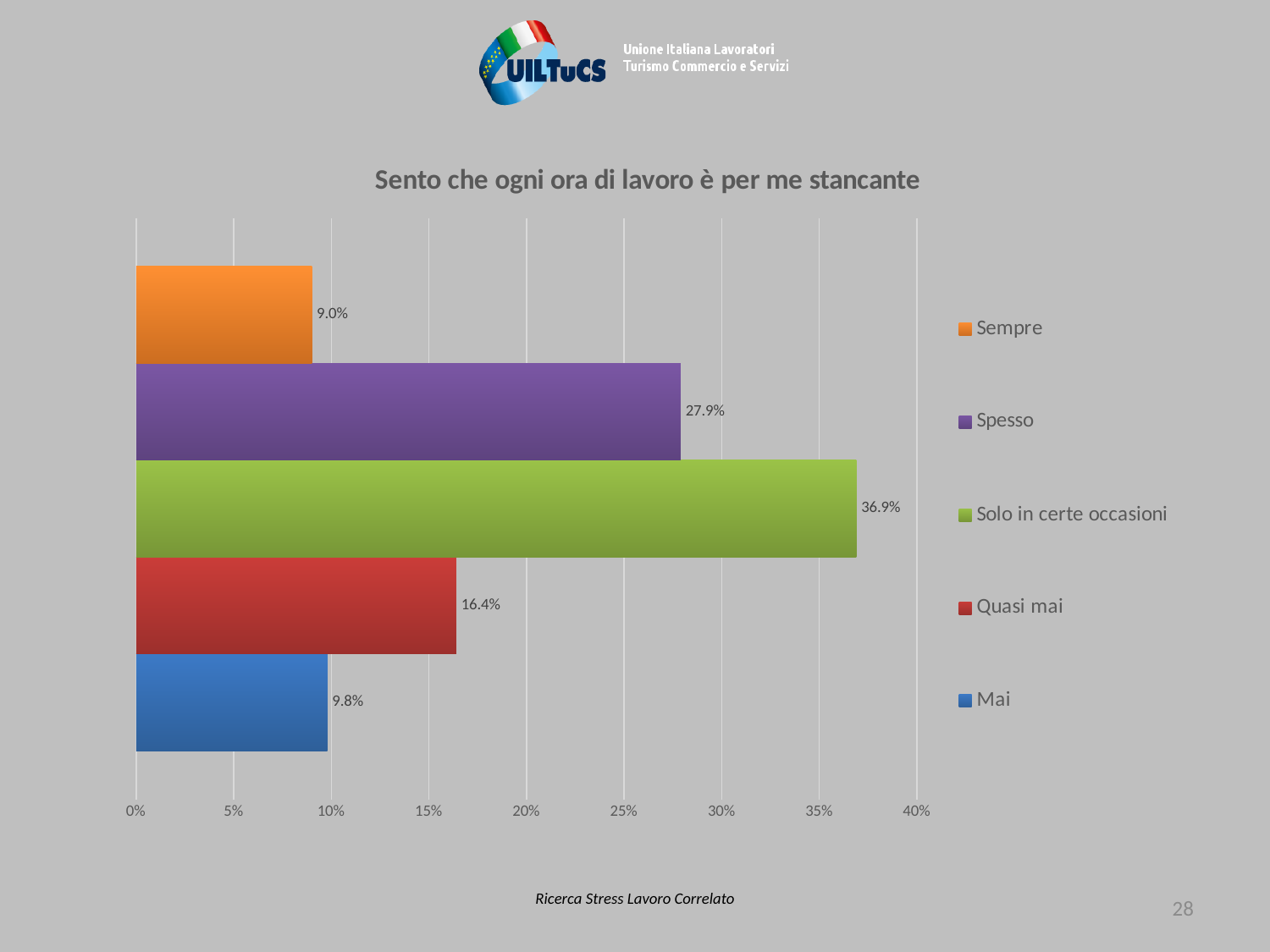
What is the value for "Spesso"? 27.9% What is the value for "Mai"? 9.8% What is the value for "Quasi mai"? 16.4% What is the difference between the values for "Solo in certe occasioni" and "Spesso"? 9.0% Which is larger, the value for "Quasi mai" or the value for "Mai"? Quasi mai Which category has the highest value? Solo in certe occasioni How many categories are shown in the chart? 5 Which category has the lowest value? Sempre What is the title of the chart? Sento che ogni ora di lavoro è per me stancante Is the value for "Spesso" greater or less than 25%? greater What kind of chart is shown on the slide? Bar chart What is the value for "Solo in certe occasioni"? 36.9%